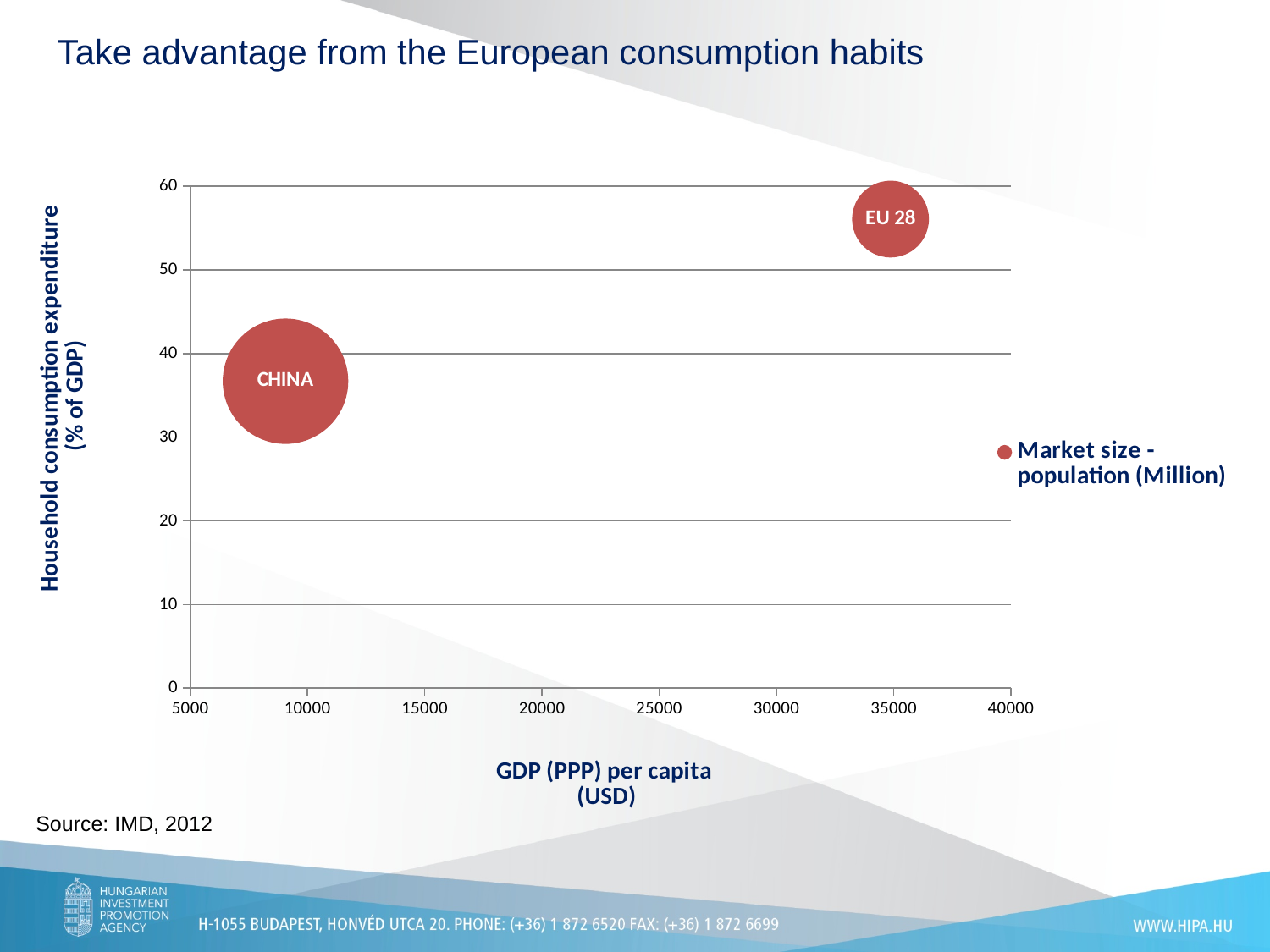
Which bubble is drawn larger, CHINA or EU 28? CHINA Is the GDP (PPP) per capita value for CHINA greater or less than 15000? less How many bubbles (data points) are plotted on the chart? 2 According to the legend, what does the bubble size represent? Market size - population (Million) Is the GDP (PPP) per capita value for EU 28 greater or less than 30000? greater What kind of chart is shown on the slide? bubble chart Which of the two plotted economies has the higher household consumption expenditure as a % of GDP? EU 28 Is the household consumption expenditure value for CHINA greater or less than 30? greater How many series does the legend list? 1 Which of the two plotted economies has the lower GDP (PPP) per capita? CHINA